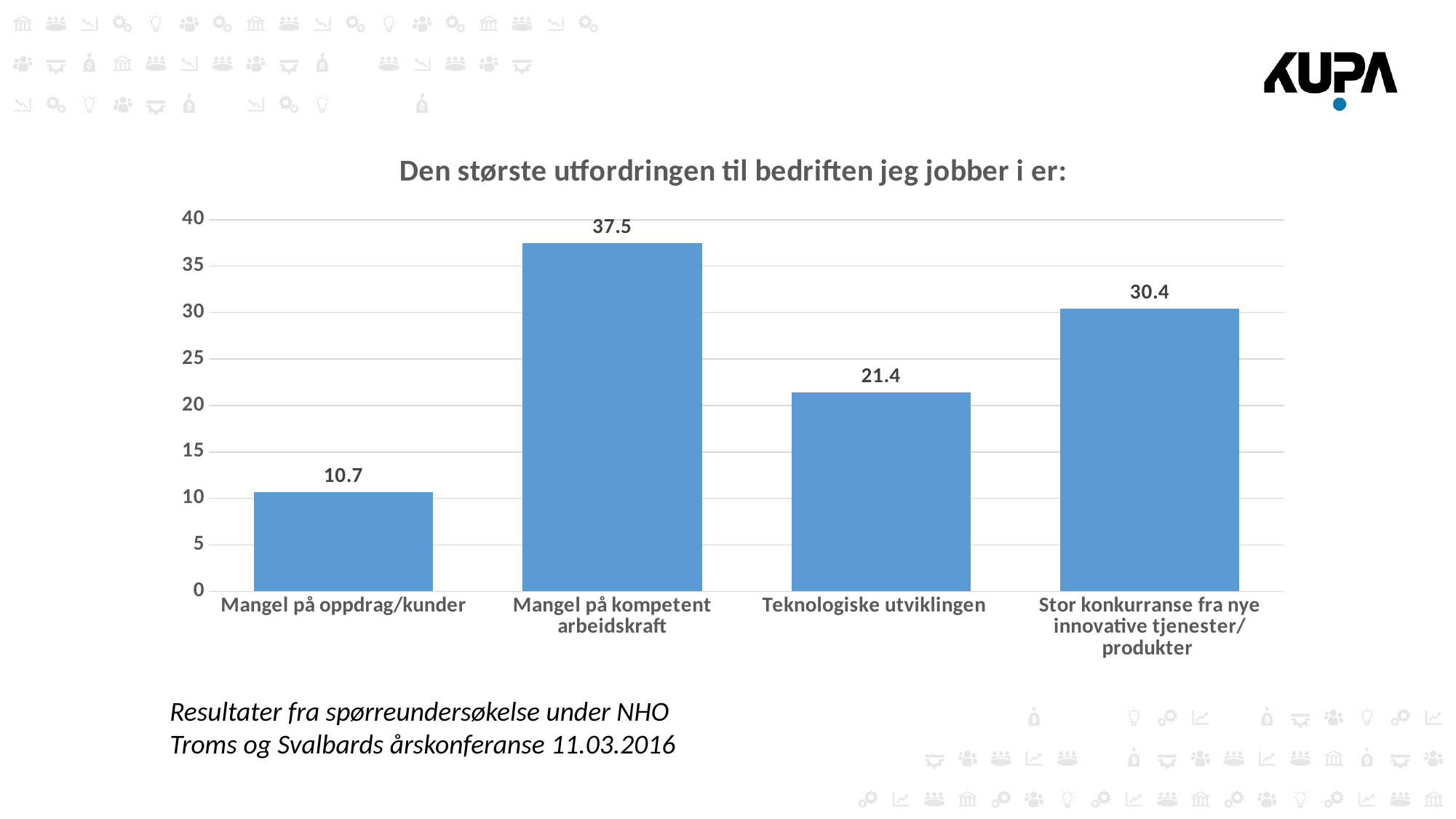
What is the difference between the values for "Teknologiske utviklingen" and "Mangel på oppdrag/kunder"? 10.7 Which category has the lowest value? Mangel på oppdrag/kunder Which is larger, the value for "Teknologiske utviklingen" or the value for "Stor konkurranse fra nye innovative tjenester/produkter"? Stor konkurranse fra nye innovative tjenester/produkter Which category has the highest value? Mangel på kompetent arbeidskraft How many categories are shown in the chart? 4 What is the value for "Mangel på oppdrag/kunder"? 10.7 Is the value for "Teknologiske utviklingen" greater or less than 25? less What is the value for "Stor konkurranse fra nye innovative tjenester/produkter"? 30.4 What is the value for "Teknologiske utviklingen"? 21.4 What is the difference between the values for "Mangel på kompetent arbeidskraft" and "Stor konkurranse fra nye innovative tjenester/produkter"? 7.1 What is the value for "Mangel på kompetent arbeidskraft"? 37.5 What kind of chart is shown on the slide? Bar chart